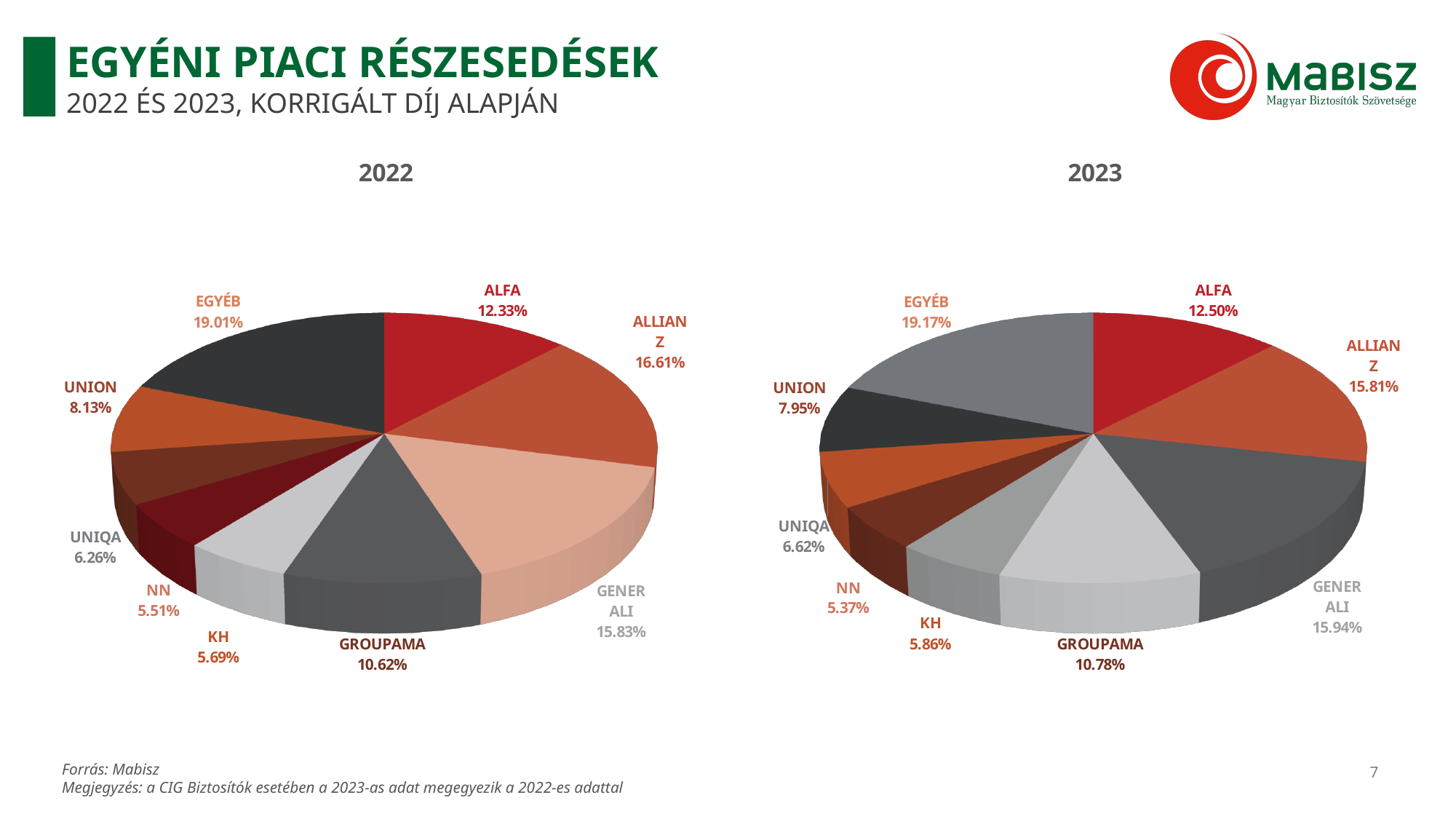
In the 2023 chart, which is larger, the share of KH or the share of NN? KH How many categories are shown in the 2022 chart? 9 In the 2023 chart, what is the share for GROUPAMA? 10.78% In the 2022 chart, which category has the smallest share? NN In the 2022 chart, which category has the largest share? EGYÉB In the 2022 chart, what is the share for ALLIANZ? 16.61% In the 2023 chart, which category has the smallest share? NN In the 2023 chart, what is the difference between the shares of EGYÉB and ALFA? 6.67% In the 2023 chart, what is the share for UNIQA? 6.62% In the 2022 chart, which is larger, the share of UNION or the share of UNIQA? UNION What kind of chart is the 2023 chart? Pie chart What is the title of the chart on the left? 2022